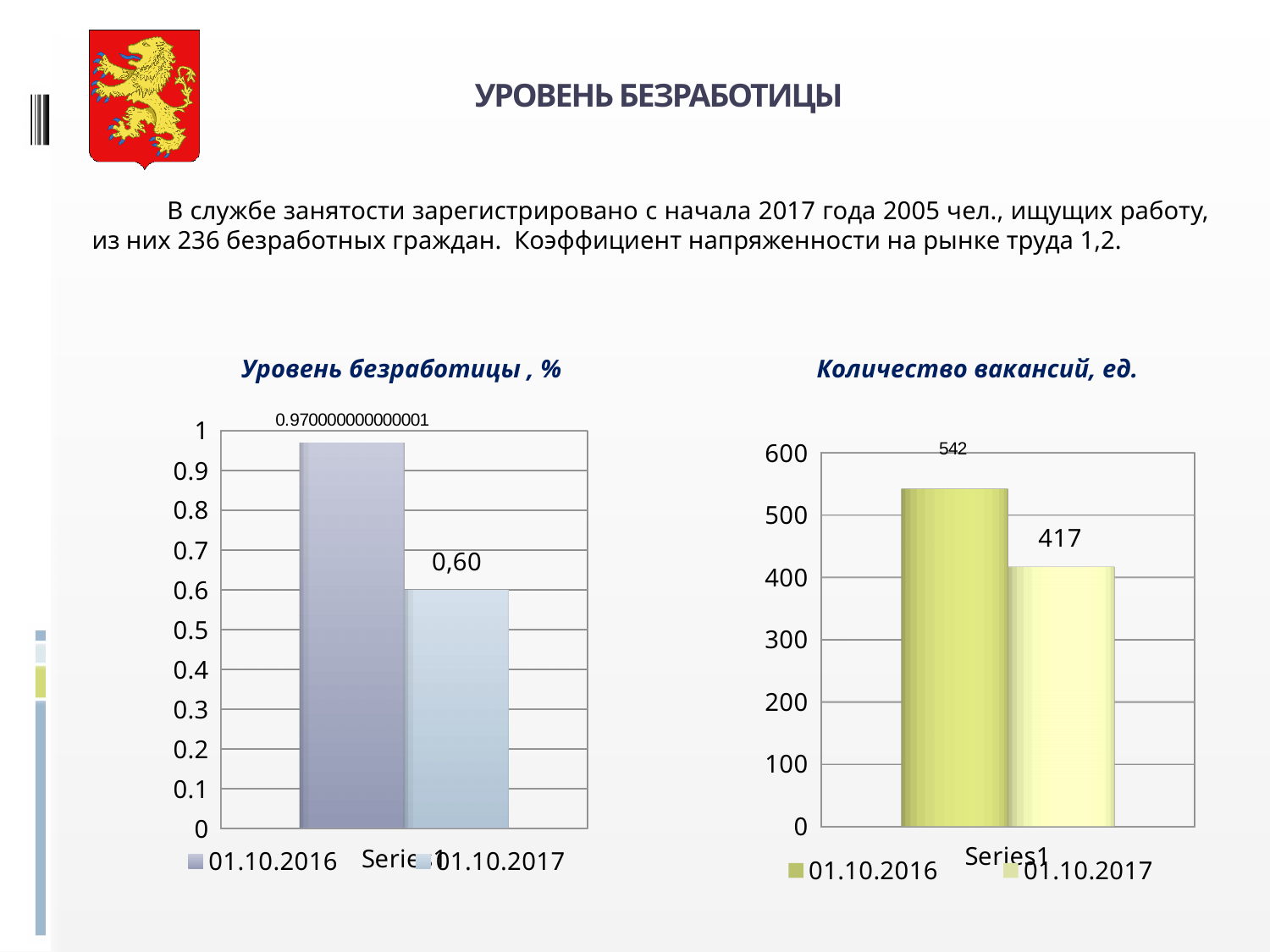
In the chart titled 'Количество вакансий, ед.', which series has the higher value, 01.10.2016 or 01.10.2017? 01.10.2016 In the chart titled 'Количество вакансий, ед.', what is the value for 01.10.2016? 542 In the chart titled 'Уровень безработицы , %', which series has the lower value? 01.10.2017 In the chart titled 'Количество вакансий, ед.', is the value for 01.10.2017 greater or less than 500? less In the chart titled 'Уровень безработицы , %', is the value for 01.10.2016 greater or less than 0.9? greater What kind of chart is the chart titled 'Уровень безработицы , %'? Bar chart In the chart titled 'Количество вакансий, ед.', what is the value for 01.10.2017? 417 What is the title of the chart on the right side of the slide? Количество вакансий, ед. In the chart titled 'Уровень безработицы , %', what is the value for 01.10.2017? 0,60 In the chart titled 'Количество вакансий, ед.', what is the difference between the 01.10.2016 and 01.10.2017 values? 125 In the chart titled 'Уровень безработицы , %', what are the two legend entries? 01.10.2016 and 01.10.2017 How many series does the legend of the chart titled 'Количество вакансий, ед.' list? 2